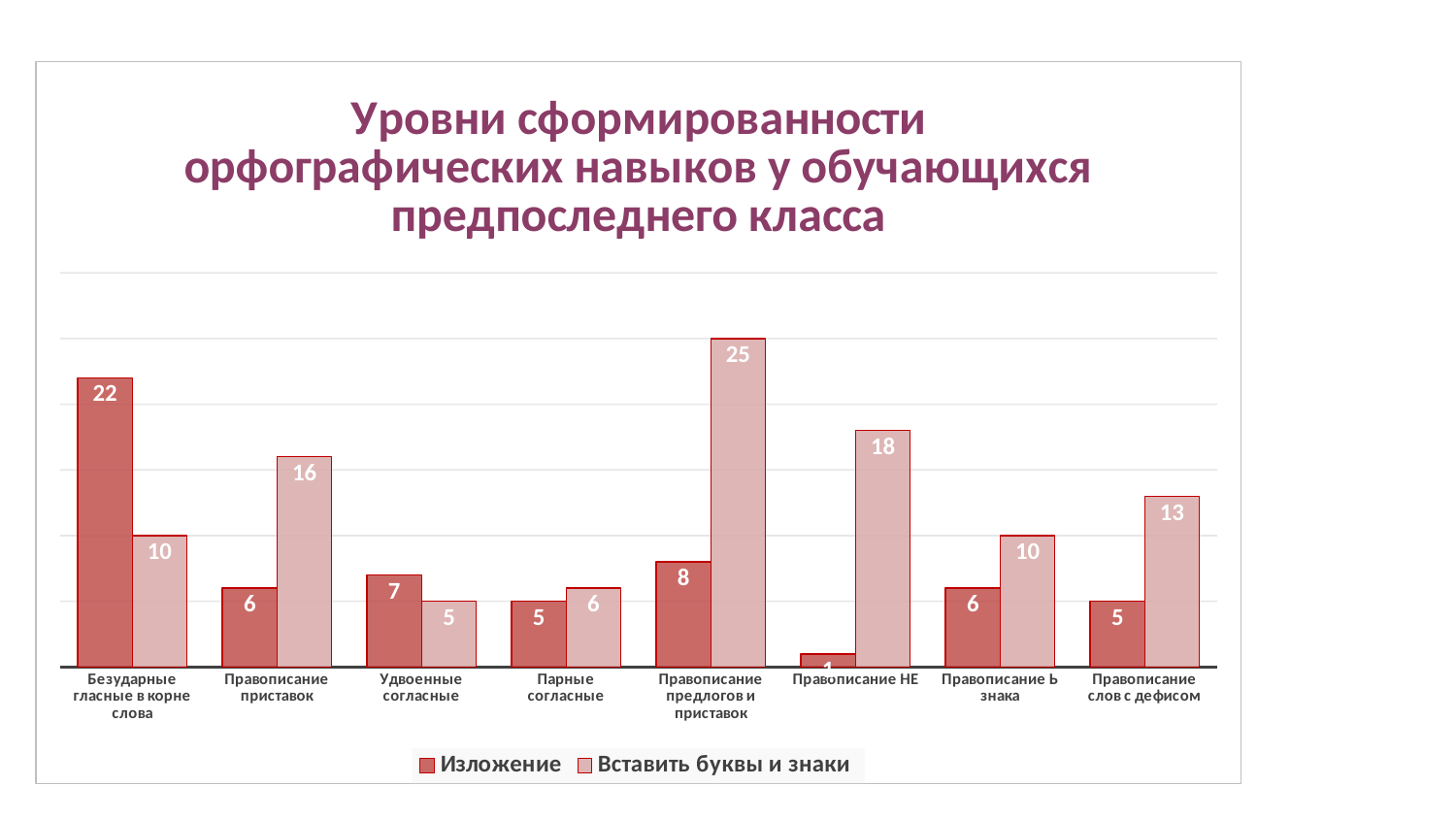
Which category has the lowest value for the series Изложение? Правописание НЕ What is the value for Изложение in the category Безударные гласные в корне слова? 22 What type of chart is shown on the slide? bar chart What is the title of the chart? Уровни сформированности орфографических навыков у обучающихся предпоследнего класса How many categories are shown on the x axis? 8 What is the value for Вставить буквы и знаки in the category Правописание НЕ? 18 What is the value for Вставить буквы и знаки in the category Правописание слов с дефисом? 13 In the category Удвоенные согласные, which series has the larger value, Изложение or Вставить буквы и знаки? Изложение What is the value for Вставить буквы и знаки in the category Правописание предлогов и приставок? 25 Which category has the highest value for the series Вставить буквы и знаки? Правописание предлогов и приставок How many series does the legend list? 2 What is the difference between the Вставить буквы и знаки value and the Изложение value in the category Правописание приставок? 10